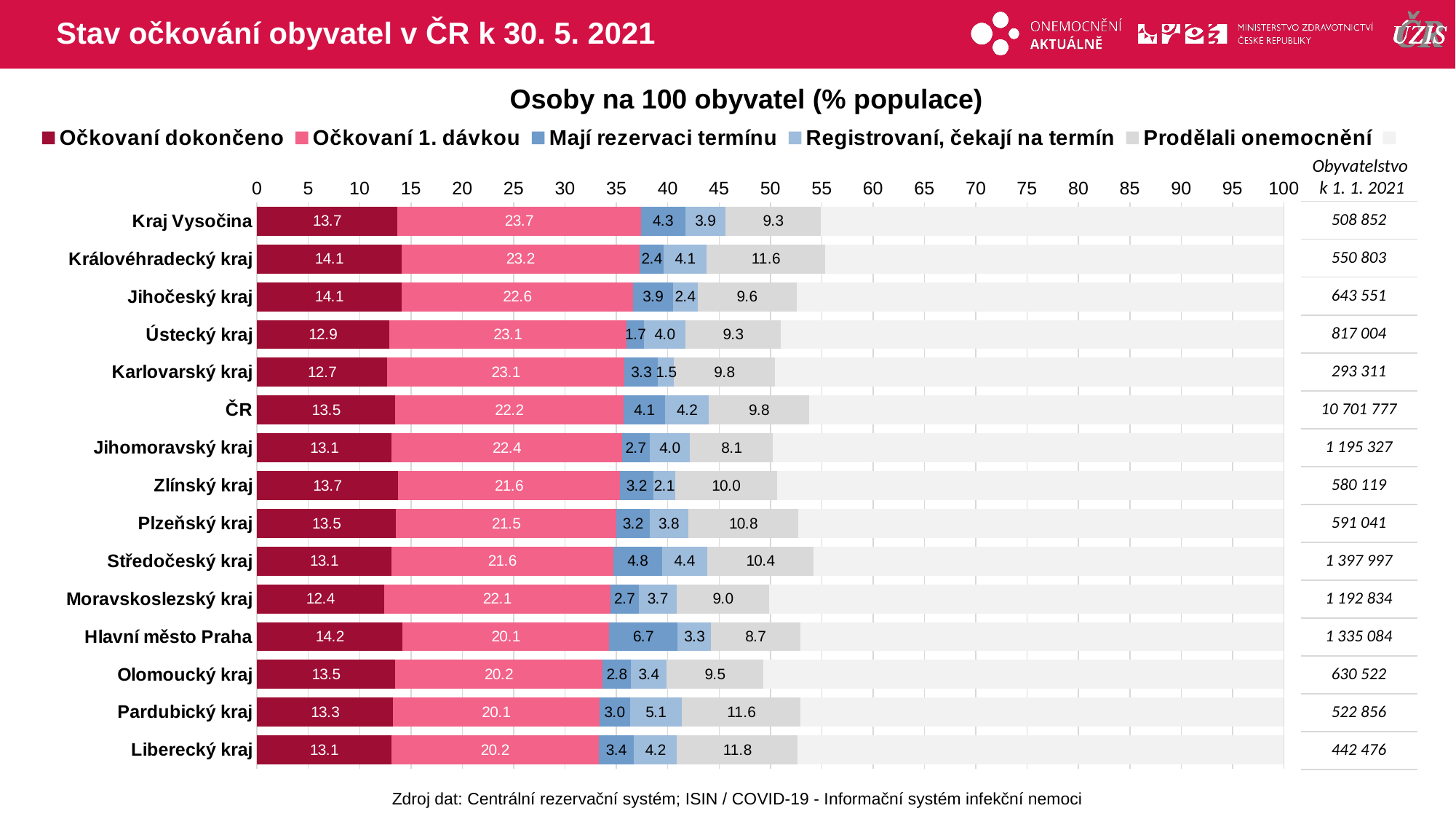
Which has the larger Očkovaní 1. dávkou value, Kraj Vysočina or Liberecký kraj? Kraj Vysočina What is the value of Očkovaní dokončeno for Kraj Vysočina? 13.7 What is the value of Prodělali onemocnění for Liberecký kraj? 11.8 What is the title of the chart? Osoby na 100 obyvatel (% populace) Is the end of the stacked bar for Kraj Vysočina (through the Prodělali onemocnění segment) greater or less than 50? greater What is the value of Očkovaní 1. dávkou for ČR? 22.2 Which category has the highest value for Mají rezervaci termínu? Hlavní město Praha Which category has the lowest value for Očkovaní dokončeno? Moravskoslezský kraj How many categories (rows) are shown in the chart? 15 What kind of chart is shown on the slide? Stacked bar chart What is the difference between the Mají rezervaci termínu values for Hlavní město Praha and Kraj Vysočina? 2.4 What is the value of Mají rezervaci termínu for Hlavní město Praha? 6.7